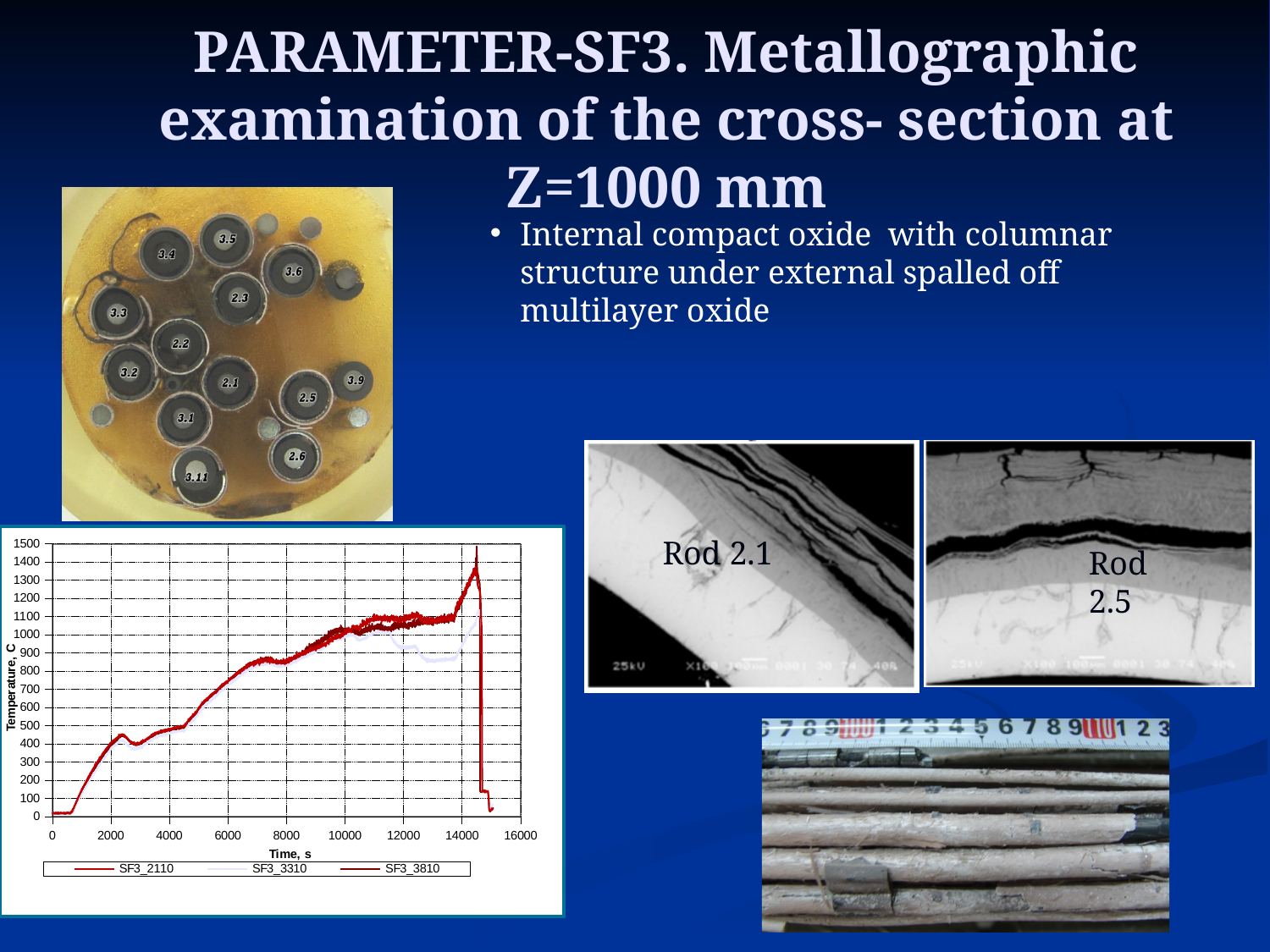
In the temperature chart, does the temperature generally rise or fall between 0 and 14000 s? rise What is the highest value shown on the y axis of the temperature chart? 1500 What kind of chart is shown at the bottom left of the slide? line chart In the temperature chart, is the temperature at time 1000 s greater or less than 300? less In the temperature chart, is the temperature at time 6000 s greater or less than 800? less In the temperature chart, is the peak temperature reached greater or less than 1200? greater How many series does the legend of the temperature chart list? 3 What are the names of the series listed in the legend of the temperature chart? SF3_2110, SF3_3310, SF3_3810 What is the highest value shown on the x axis (Time, s) of the temperature chart? 16000 What is the label of the y axis of the temperature chart? Temperature, C